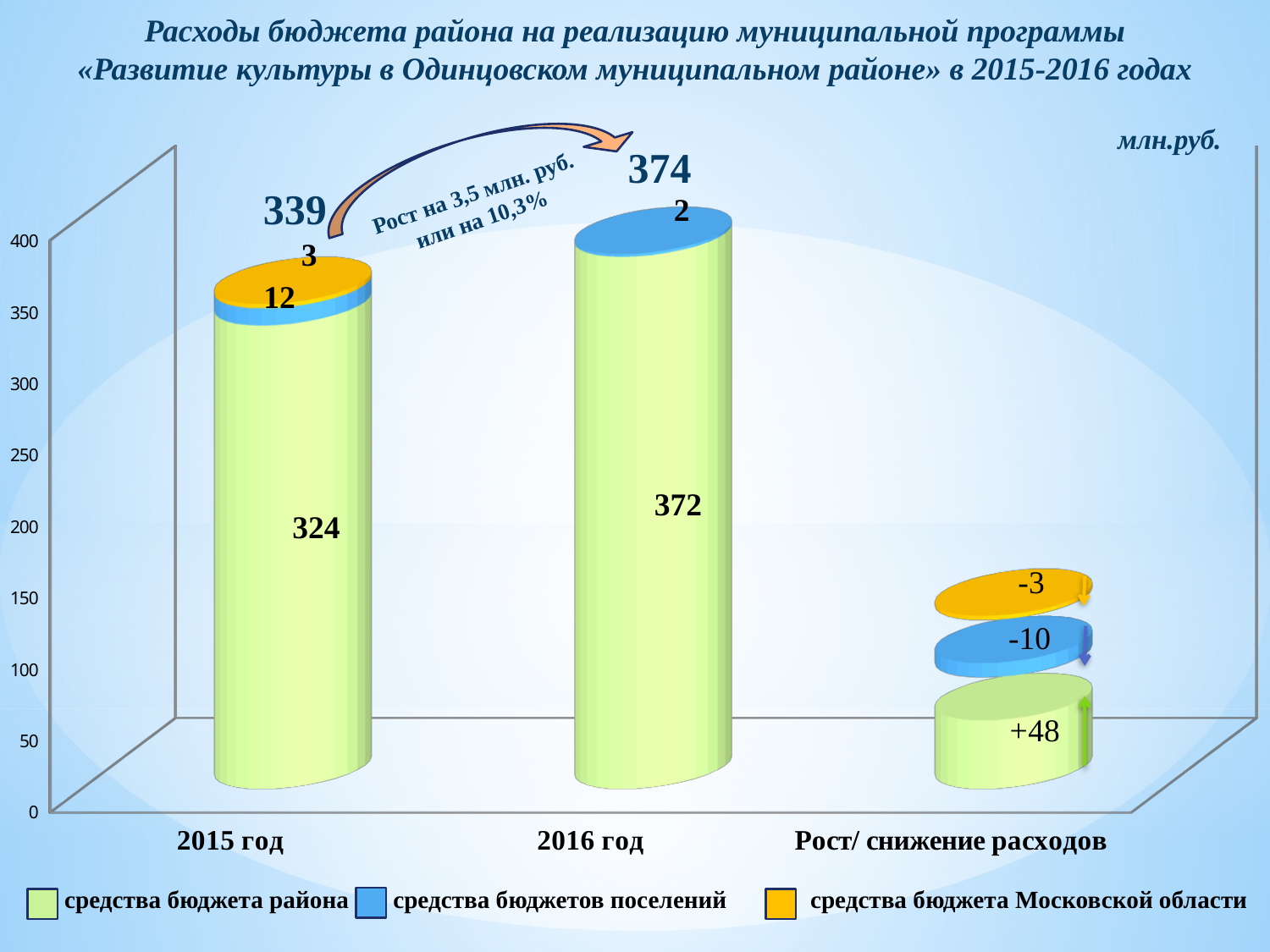
What is the value of средства бюджета района for 2016 год? 372 What is the value of средства бюджета Московской области for 2015 год? 3 What kind of chart is shown on the slide? bar chart What is the total of the stacked bar for 2015 год? 339 How many categories are shown on the x axis? 3 What is the value of средства бюджетов поселений for 2016 год? 2 What is the value of средства бюджетов поселений for 2015 год? 12 How many series does the legend list? 3 What is the value of средства бюджета района for 2015 год? 324 What is the difference between средства бюджета района in 2016 год and 2015 год? 48 Which year has the larger value for средства бюджетов поселений, 2015 год or 2016 год? 2015 год What is the total of the stacked bar for 2016 год? 374